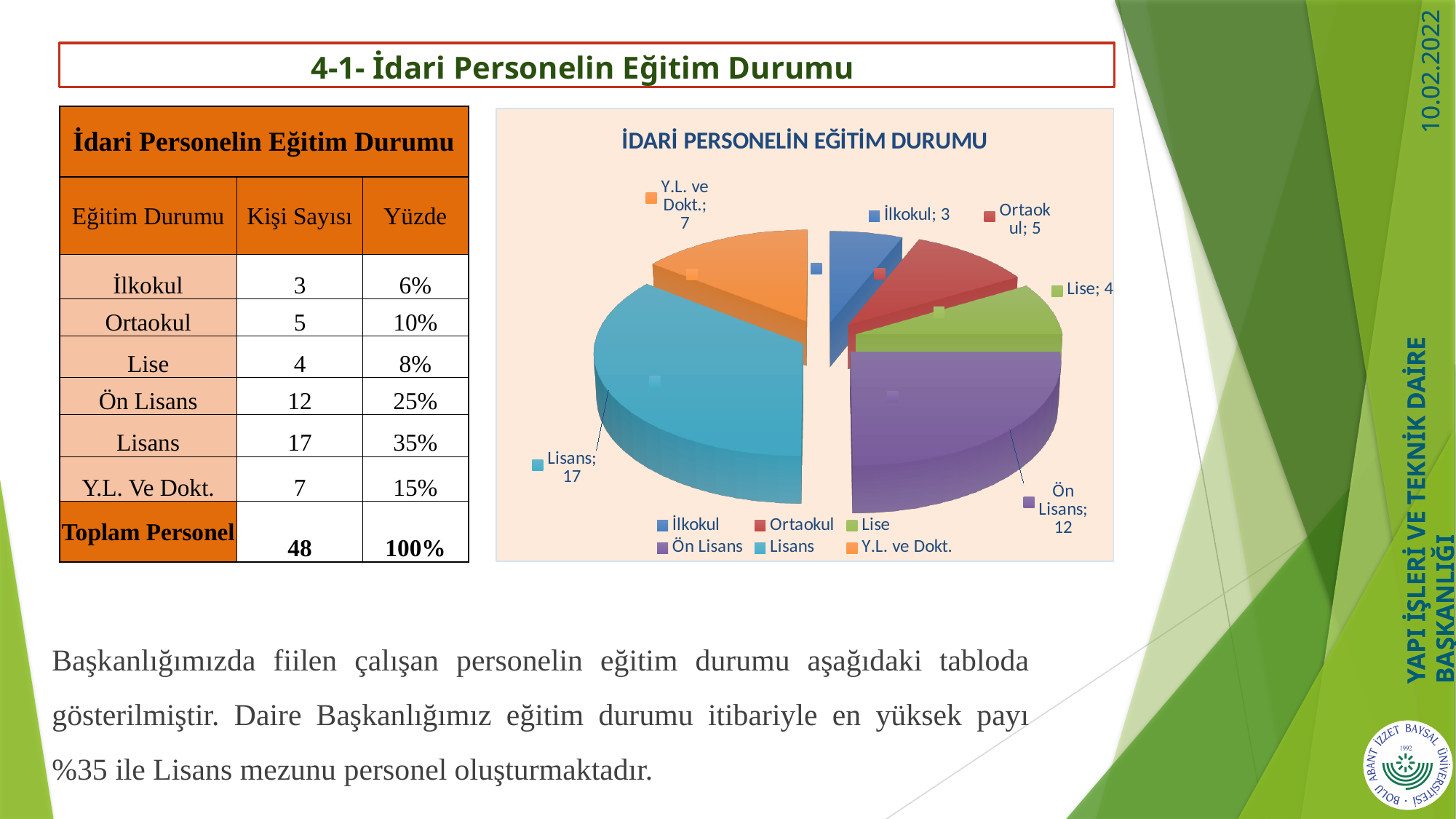
How many categories does the pie chart show? 6 Which is larger in the pie chart, Ortaokul or Lise? Ortaokul What is the value for Y.L. ve Dokt. in the pie chart? 7 What is the difference between the values for Lisans and Ön Lisans in the pie chart? 5 What is the value for Ortaokul in the pie chart? 5 What is the value for Ön Lisans in the pie chart? 12 What is the value for Lisans in the pie chart? 17 Which category has the largest slice in the pie chart? Lisans What kind of chart is shown on the slide? pie chart What is the title of the pie chart? İDARİ PERSONELİN EĞİTİM DURUMU What share of the pie does Lisans represent? 35% Which category has the smallest slice in the pie chart? İlkokul